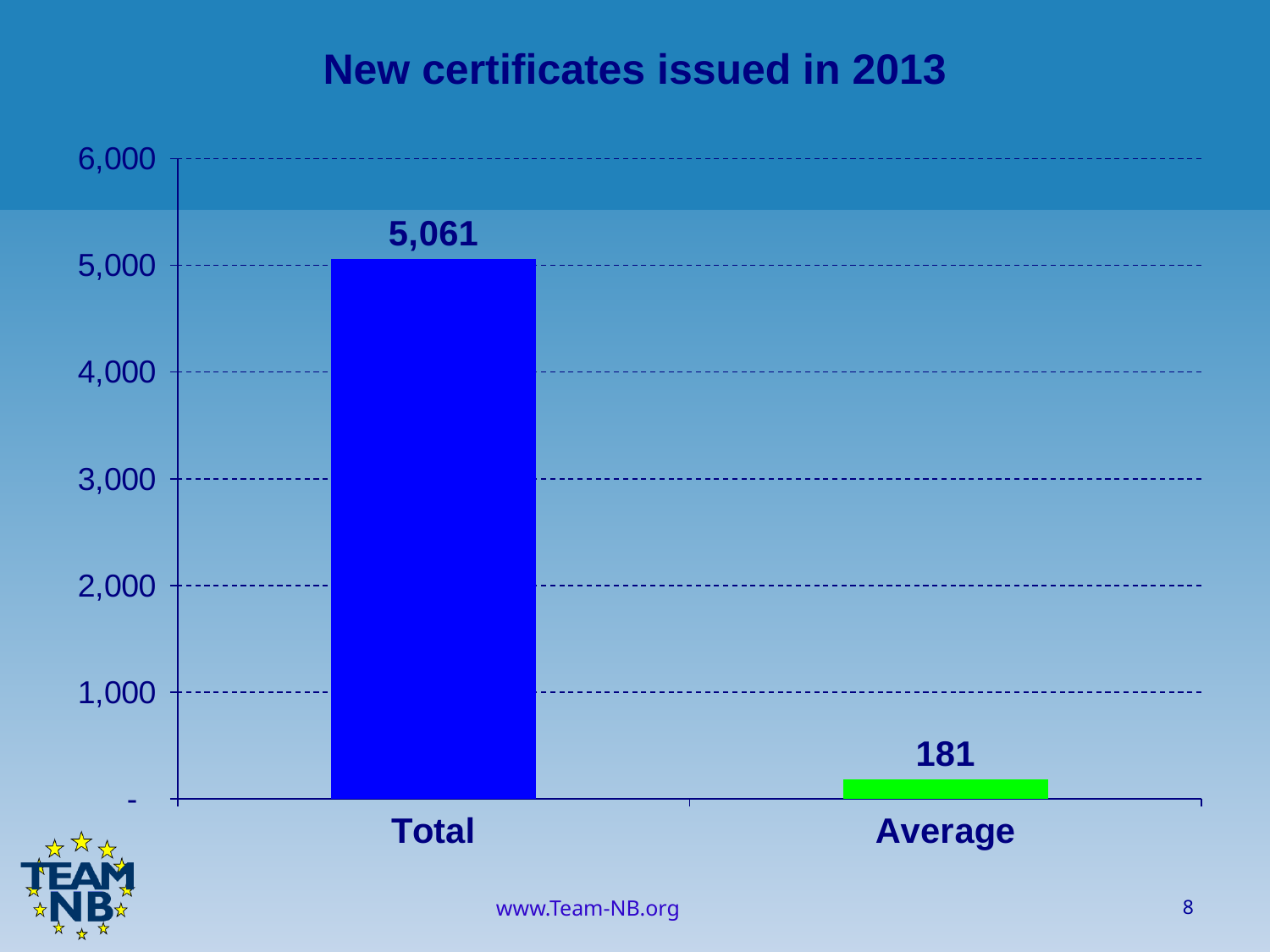
What is the difference between the Total and Average values? 4,880 Which is larger, the Total value or the Average value? Total What colour is the Average bar? green How many categories are shown on the x axis? 2 Is the value for Average greater or less than 1,000? less What is the title of the chart? New certificates issued in 2013 Is the value for Total greater or less than 5,000? greater What kind of chart is shown on the slide? bar chart What is the value of the Average bar? 181 What is the value of the Total bar? 5,061 Which category has the lowest value? Average Which category has the highest value? Total